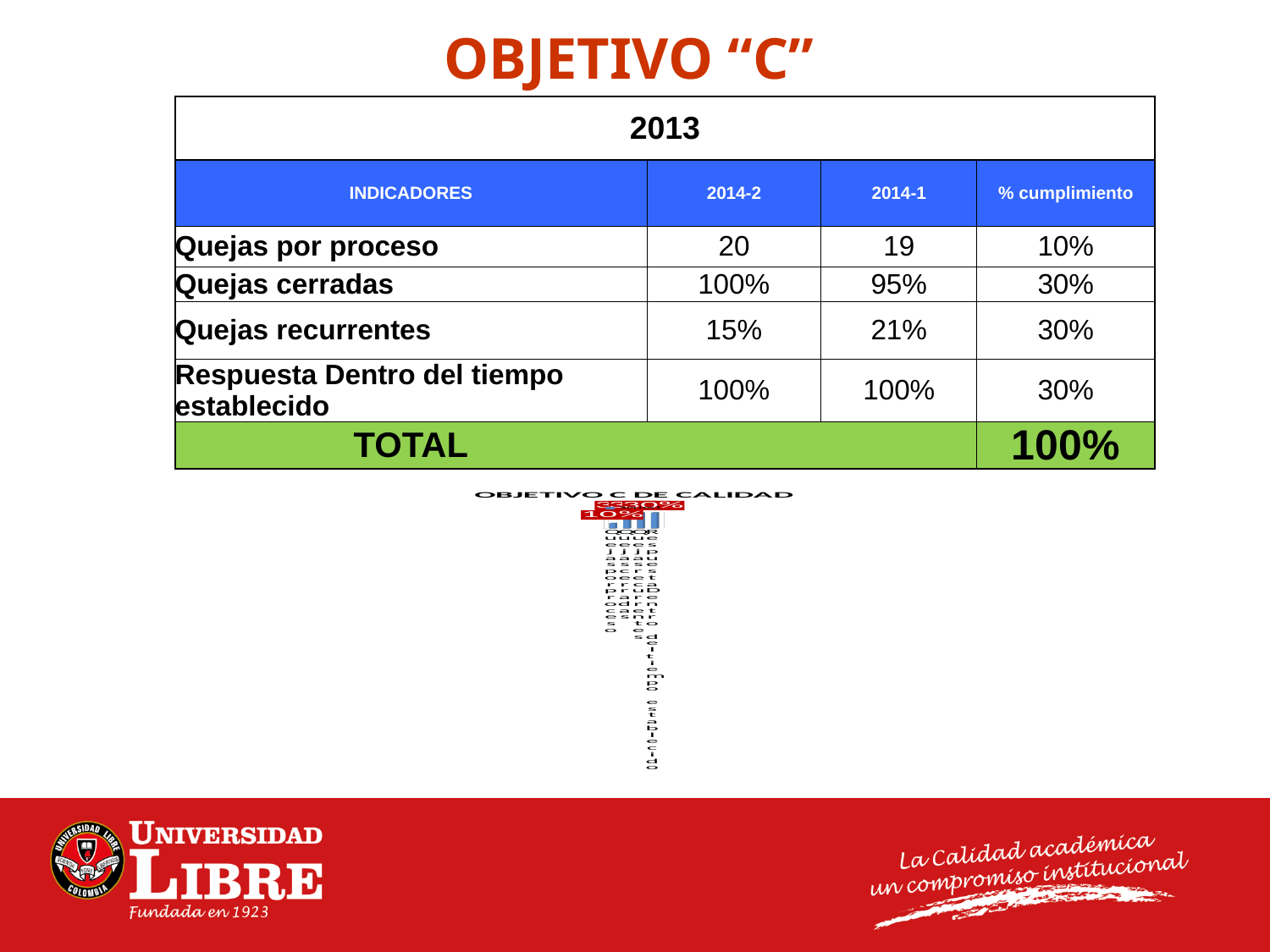
In the chart 'OBJETIVO C DE CALIDAD', what is the value shown for Quejas por proceso? 10% What kind of chart is shown below the table on the slide? bar chart In the chart 'OBJETIVO C DE CALIDAD', which is larger: the bar for Quejas cerradas or the bar for Quejas por proceso? Quejas cerradas What is the title of the chart on the slide? OBJETIVO C DE CALIDAD How many bars does the chart 'OBJETIVO C DE CALIDAD' show? 4 In the chart 'OBJETIVO C DE CALIDAD', what is the value shown for Quejas cerradas? 30% In the chart 'OBJETIVO C DE CALIDAD', which category has the lowest bar? Quejas por proceso